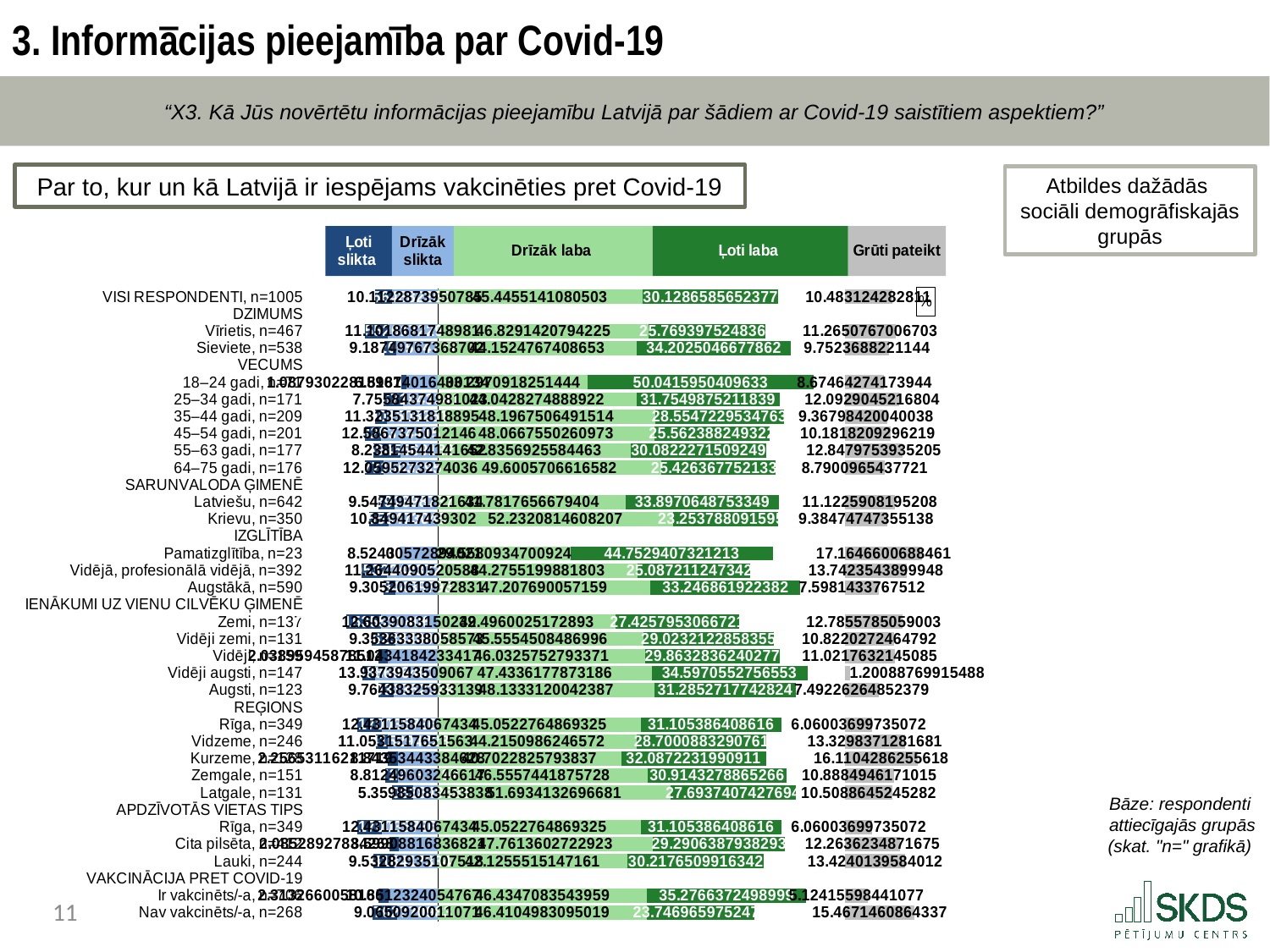
What type of chart is shown on the slide? bar chart Which has the larger 'Ļoti laba' value, 'Sieviete, n=538' or 'Vīrietis, n=467'? Sieviete, n=538 What is the 'Grūti pateikt' value for 'Pamatizglītība, n=23'? 17.1646600688461 What is the title of the chart? Par to, kur un kā Latvijā ir iespējams vakcinēties pret Covid-19 What is the 'Ļoti laba' value for 'Sieviete, n=538'? 34.2025046677862 How many age groups (VECUMS) are shown in the chart? 6 What is the 'Ļoti laba' value for 'Vīrietis, n=467'? 25.769397524836 How many series does the chart legend list? 5 What is the difference between the 'Ļoti laba' values for 'Sieviete, n=538' and 'Vīrietis, n=467'? 8.4331071429502 Which group has the highest 'Ļoti laba' value? 18–24 gadi What is the 'Grūti pateikt' value for 'Rīga, n=349'? 6.06003699735072